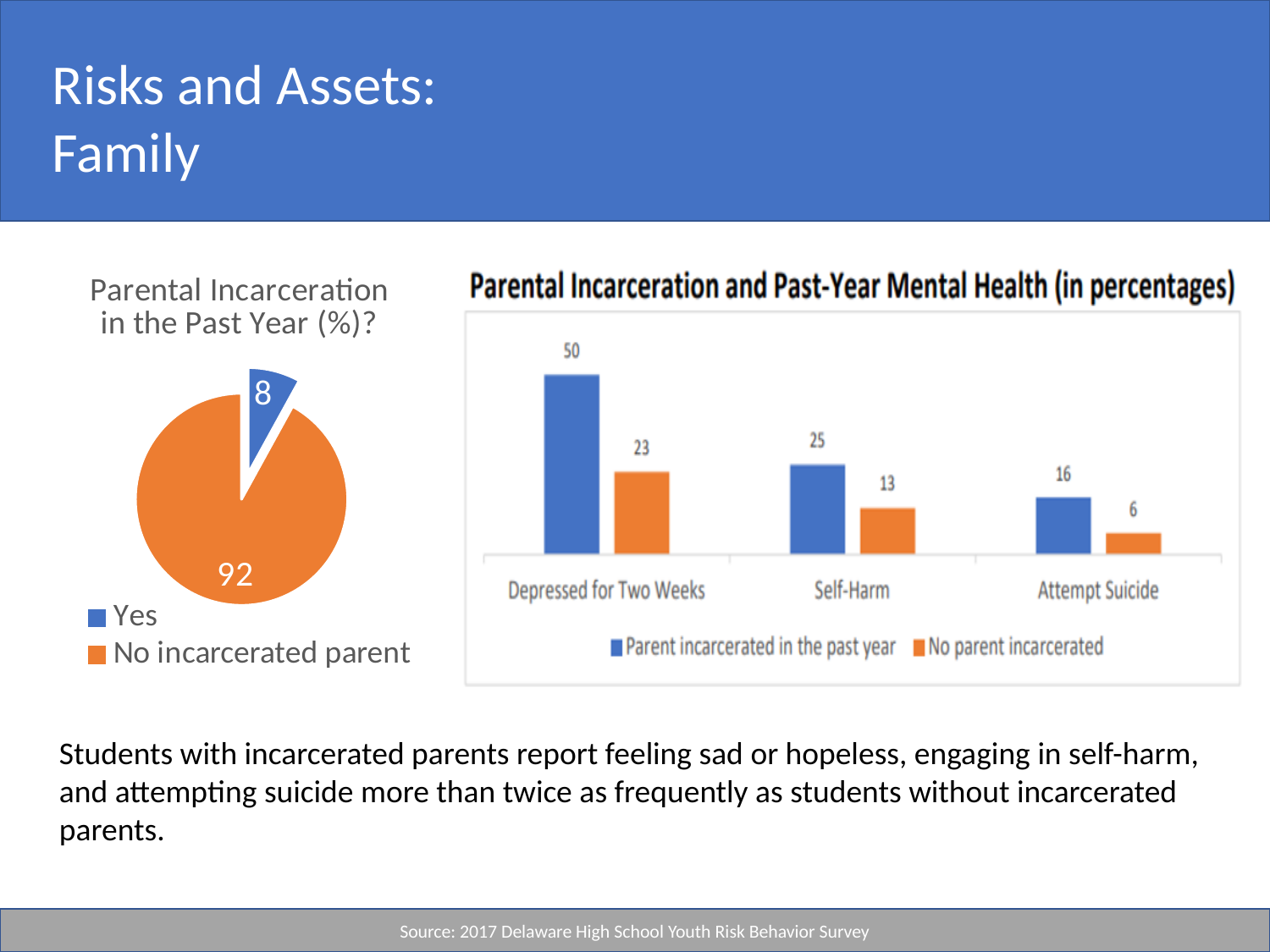
How many categories are shown on the x axis of the bar chart 'Parental Incarceration and Past-Year Mental Health (in percentages)'? 3 In the pie chart 'Parental Incarceration in the Past Year (%)?', which slice is the largest? No incarcerated parent How many series does the legend of the bar chart 'Parental Incarceration and Past-Year Mental Health (in percentages)' list? 2 In the bar chart 'Parental Incarceration and Past-Year Mental Health (in percentages)', what is the value for 'Attempt Suicide' for the series 'Parent incarcerated in the past year'? 16 In the bar chart 'Parental Incarceration and Past-Year Mental Health (in percentages)', what is the value for 'Self-Harm' for the series 'No parent incarcerated'? 13 In the bar chart 'Parental Incarceration and Past-Year Mental Health (in percentages)', what is the value for 'Depressed for Two Weeks' for the series 'Parent incarcerated in the past year'? 50 In the pie chart 'Parental Incarceration in the Past Year (%)?', what is the value for 'Yes'? 8 In the pie chart 'Parental Incarceration in the Past Year (%)?', what is the value for 'No incarcerated parent'? 92 In the bar chart 'Parental Incarceration and Past-Year Mental Health (in percentages)', which category has the lowest value for the series 'No parent incarcerated'? Attempt Suicide What kind of chart is the chart on the left of the slide? Pie chart In the bar chart 'Parental Incarceration and Past-Year Mental Health (in percentages)', which is larger for 'Self-Harm': 'Parent incarcerated in the past year' or 'No parent incarcerated'? Parent incarcerated in the past year In the bar chart 'Parental Incarceration and Past-Year Mental Health (in percentages)', what is the difference between the two series for 'Depressed for Two Weeks'? 27